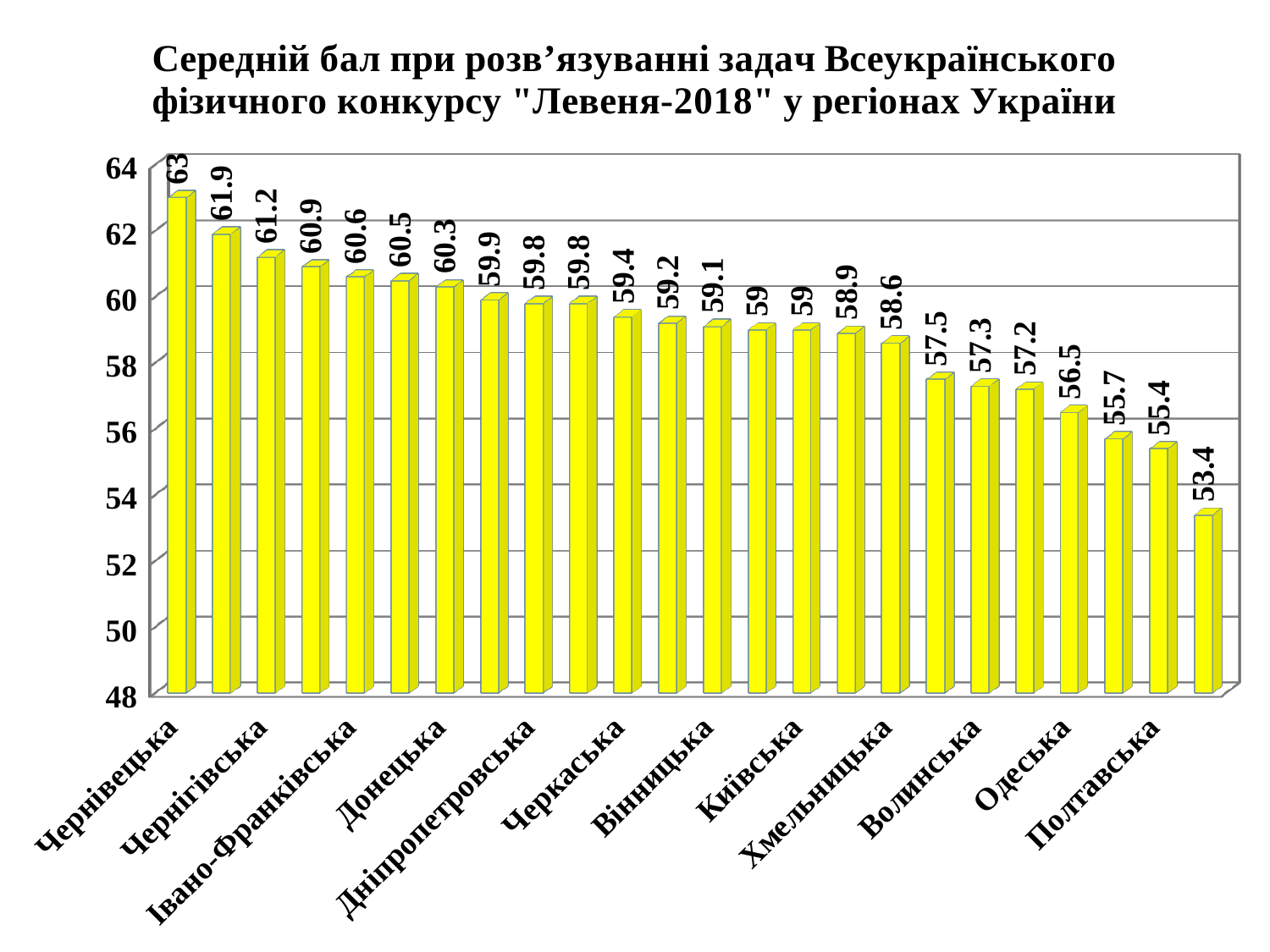
What kind of chart is shown on the slide? bar chart What is the average score for Полтавська? 55.4 What is the lowest value shown on the chart? 53.4 What is the average score for Одеська? 56.5 What is the difference between the scores for Чернівецька and Полтавська? 7.6 Do the values rise or fall from left to right along the x axis? fall Which has a higher average score, Донецька or Одеська? Донецька What is the average score for Київська? 59 What is the average score for Чернівецька? 63 Which region has the highest average score? Чернівецька Is the value for Волинська greater or less than 58? less How many bars are plotted on the chart? 24